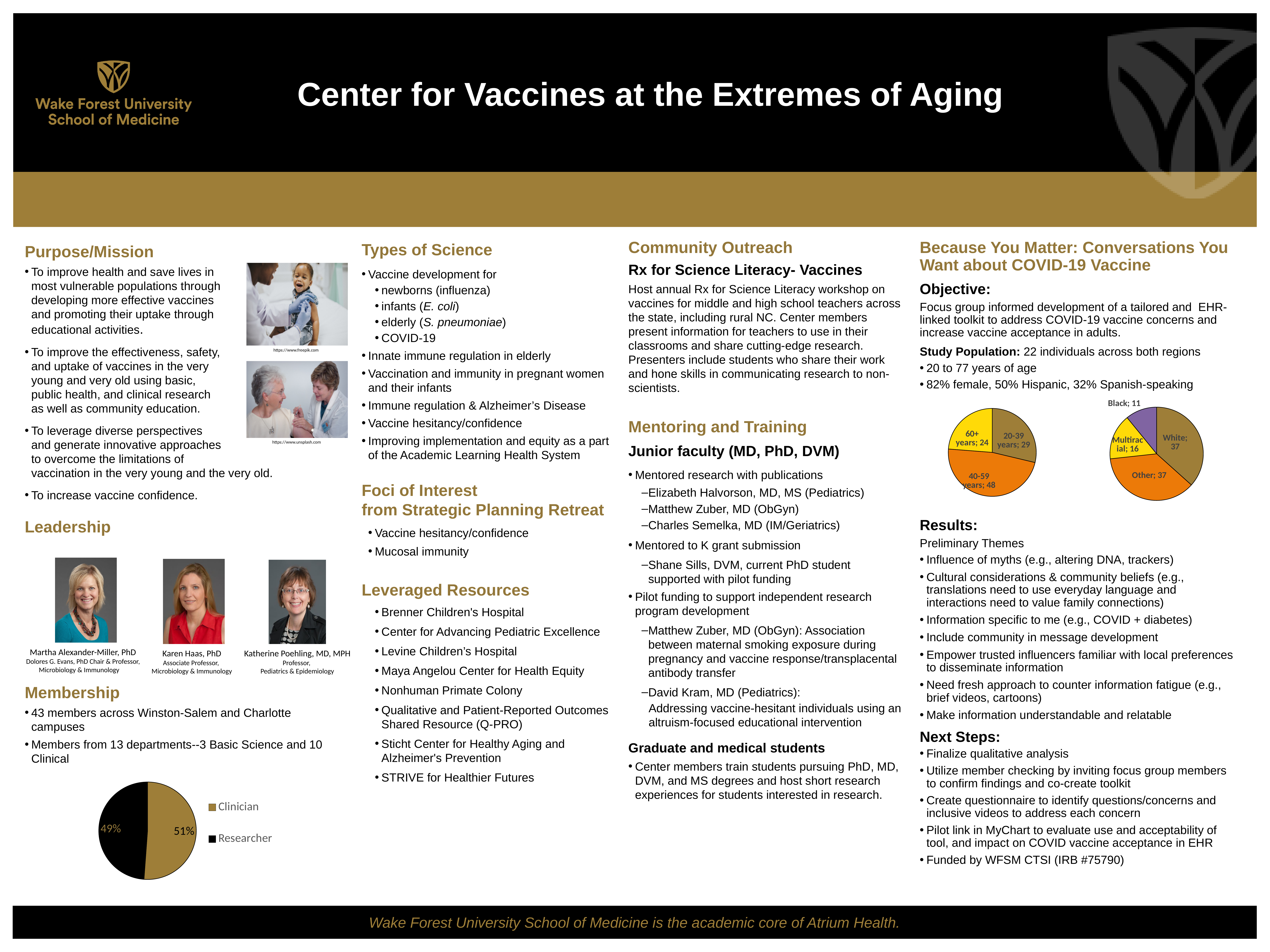
In the age pie chart under 'Because You Matter', what value is shown for 40-59 years? 48 In the race pie chart under 'Because You Matter', what value is shown for Multiracial? 16 In the Membership pie chart, what share is labelled Researcher? 49% In the Membership pie chart, which slice is larger, Clinician or Researcher? Clinician In the age pie chart under 'Because You Matter', which age group has the smallest value? 60+ years In the Membership pie chart, what share is labelled Clinician? 51% How many slices does the race pie chart under 'Because You Matter' have? 4 How many entries does the legend of the Membership pie chart list? 2 In the age pie chart under 'Because You Matter', what is the difference between the 40-59 years value and the 20-39 years value? 19 What kind of chart is used in the Membership section? pie chart How many slices does the age pie chart under 'Because You Matter' have? 3 In the race pie chart under 'Because You Matter', what value is shown for Black? 11